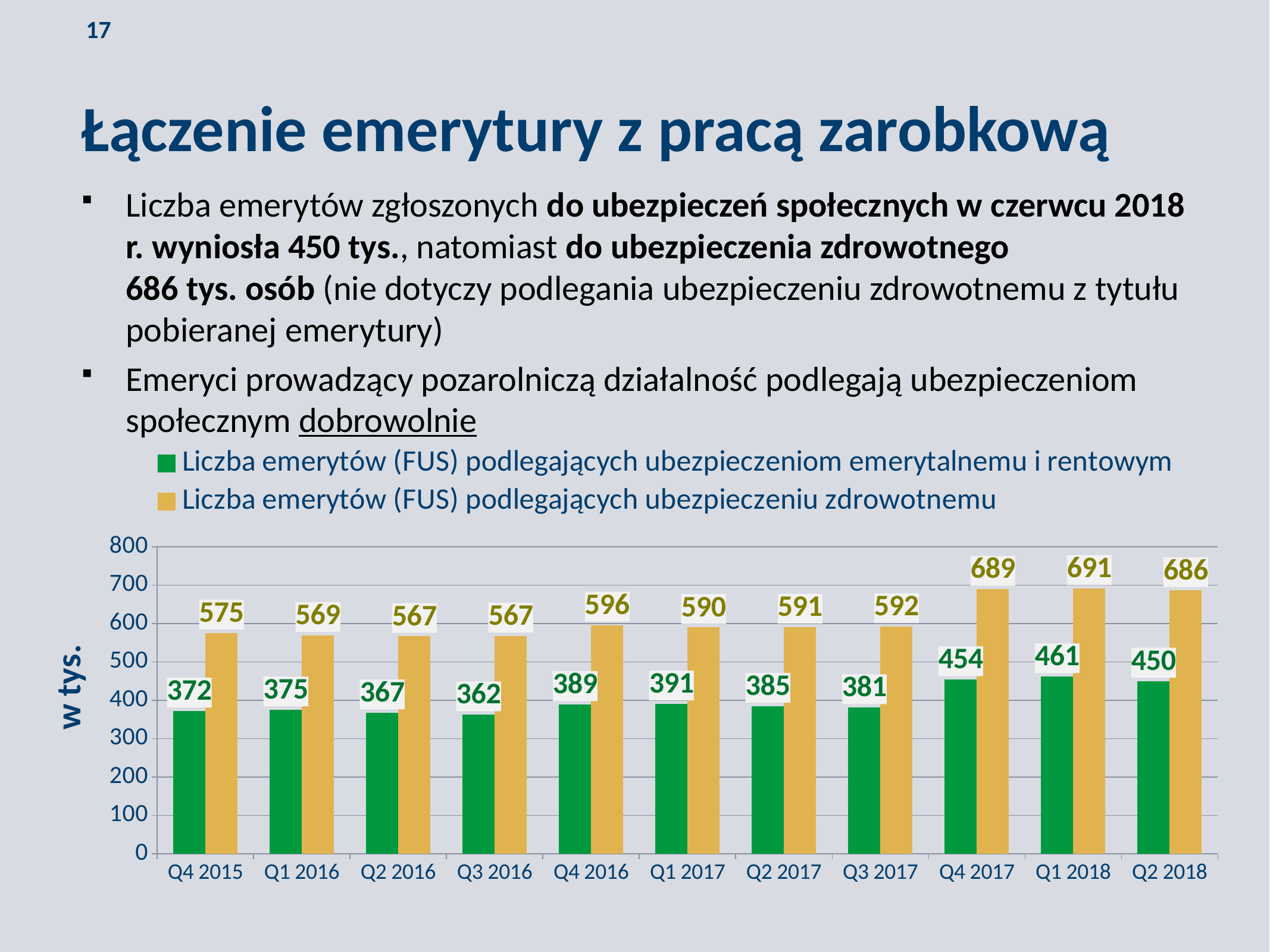
What kind of chart is shown on the slide? bar chart Does 'Liczba emerytów (FUS) podlegających ubezpieczeniu zdrowotnemu' rise or fall from Q3 2017 to Q4 2017? rise What is the label on the vertical axis? w tys. In which quarter is 'Liczba emerytów (FUS) podlegających ubezpieczeniu zdrowotnemu' highest? Q1 2018 Which is larger: the green bar for Q4 2017 or the green bar for Q1 2018? Q1 2018 What is the value for 'Liczba emerytów (FUS) podlegających ubezpieczeniom emerytalnemu i rentowym' in Q2 2018? 450 What is the difference between the two series' values in Q2 2018? 236 Is the value for 'Liczba emerytów (FUS) podlegających ubezpieczeniu zdrowotnemu' in Q4 2017 greater or less than 600? greater How many quarters are shown on the x axis? 11 What is the value for 'Liczba emerytów (FUS) podlegających ubezpieczeniu zdrowotnemu' in Q4 2015? 575 In which quarter is 'Liczba emerytów (FUS) podlegających ubezpieczeniom emerytalnemu i rentowym' lowest? Q3 2016 How many series does the legend list? 2